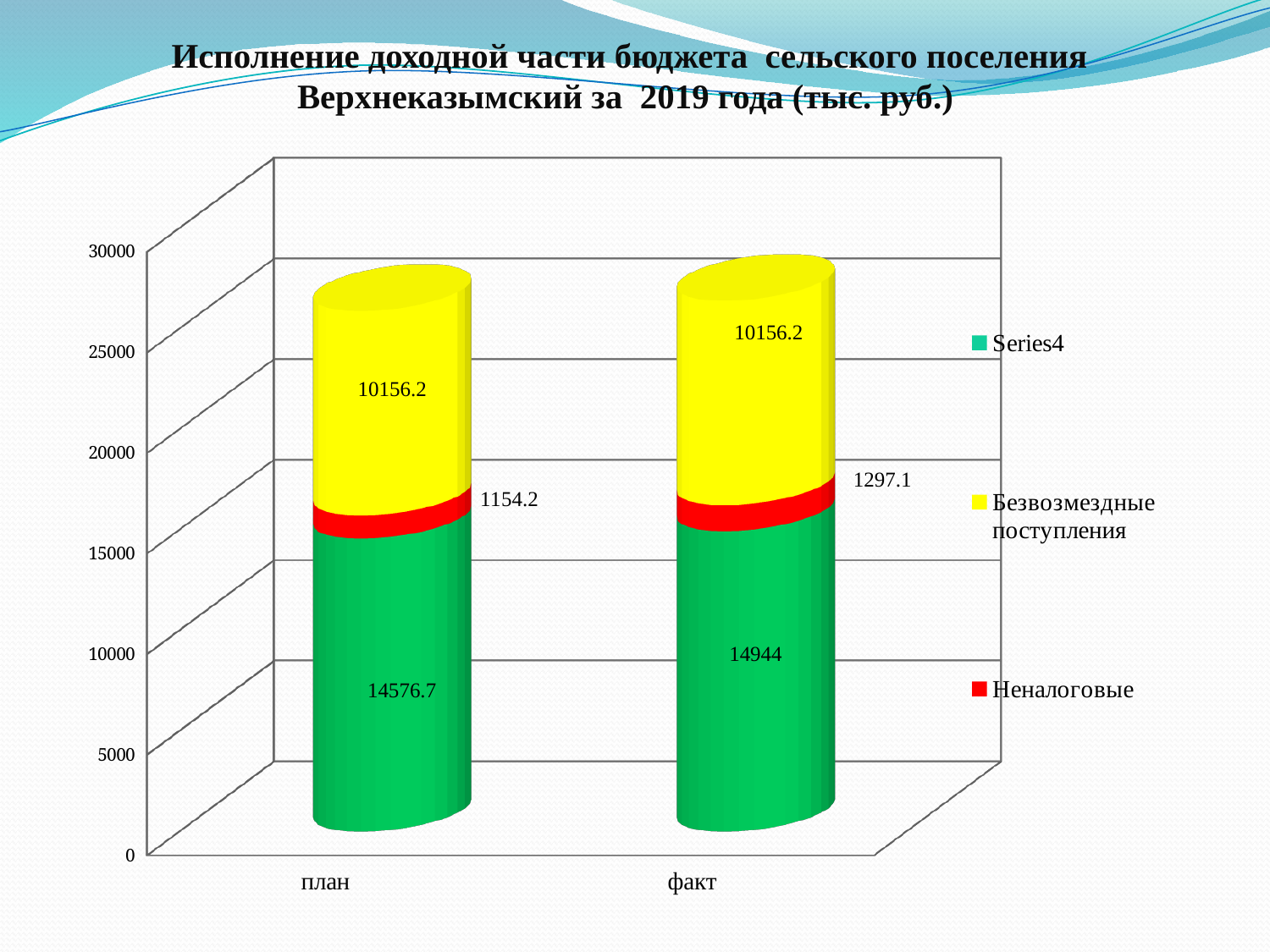
What is the difference between the Неналоговые values for факт and план? 142.9 What is the value of Неналоговые for план? 1154.2 How many series does the legend list? 3 Which category has the larger Series4 value, план or факт? факт What is the difference between the Series4 values for факт and план? 367.3 What is the value of Безвозмездные поступления for факт? 10156.2 What is the value of Series4 for план? 14576.7 What is the value of Неналоговые for факт? 1297.1 How many categories are shown on the x axis? 2 What is the value of Series4 for факт? 14944 What is the total of the stacked bar for план? 25887.1 What type of chart is shown on the slide? stacked bar chart